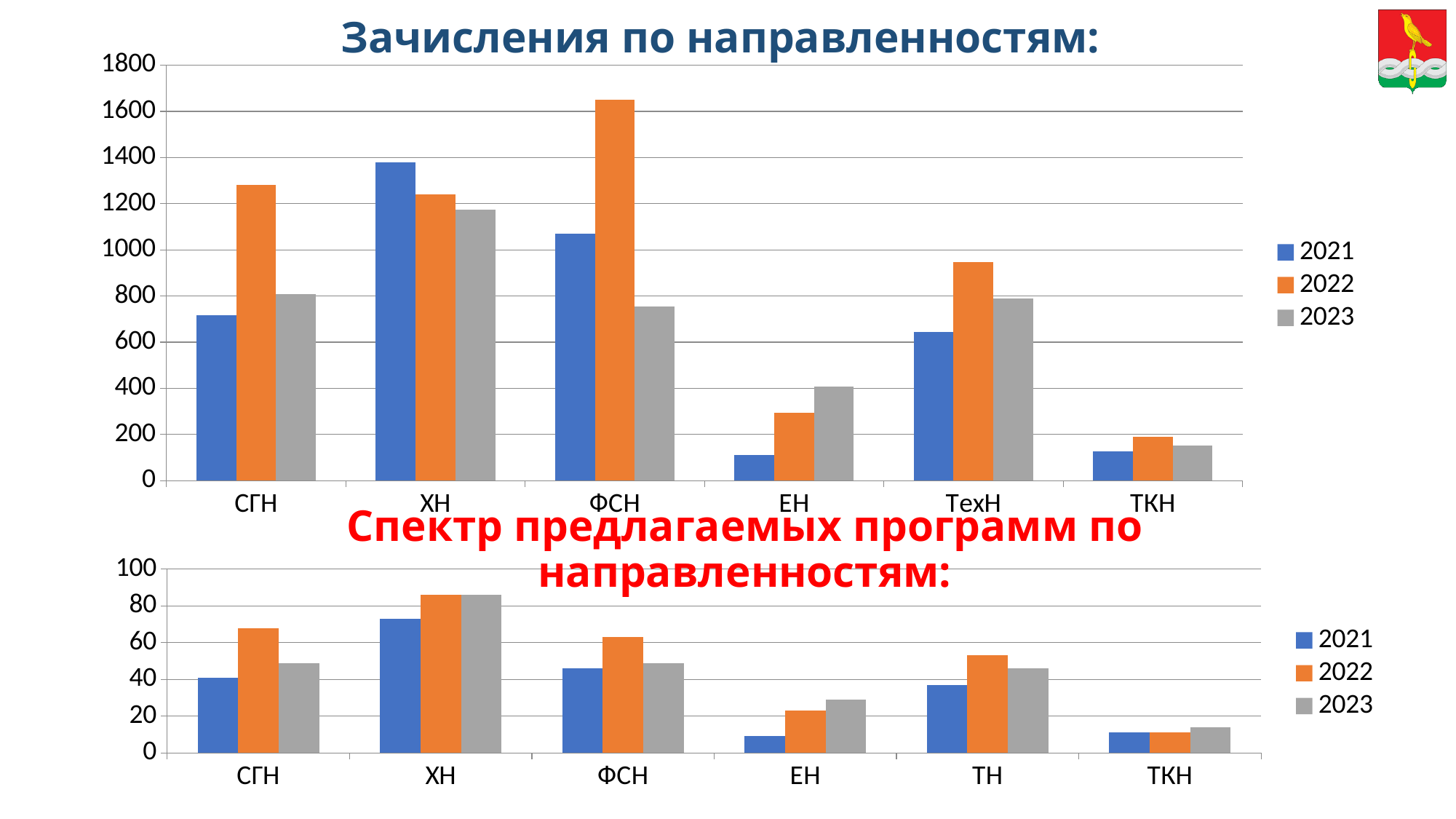
In the top chart 'Зачисления по направленностям', which is larger for ТехН: the 2022 value or the 2023 value? 2022 In the top chart 'Зачисления по направленностям', which category has the tallest bar for the 2021 series? ХН In the top chart 'Зачисления по направленностям', is the 2021 value for ХН greater or less than 1200? greater In the top chart 'Зачисления по направленностям', how many series does the legend list? 3 In the bottom chart 'Спектр предлагаемых программ по направленностям', which category has the highest value for the 2021 series? ХН What type of chart is the bottom chart 'Спектр предлагаемых программ по направленностям'? bar chart In the bottom chart 'Спектр предлагаемых программ по направленностям', is the 2022 value for СГН greater or less than 60? greater In the top chart 'Зачисления по направленностям', how many categories are shown on the x axis? 6 In the top chart 'Зачисления по направленностям', which category has the lowest value for the 2022 series? ТКН In the bottom chart 'Спектр предлагаемых программ по направленностям', which category has the lowest value for the 2023 series? ТКН In the top chart 'Зачисления по направленностям', is the 2023 value for ЕН greater or less than 600? less In the bottom chart 'Спектр предлагаемых программ по направленностям', which is larger for ФСН: the 2022 value or the 2023 value? 2022